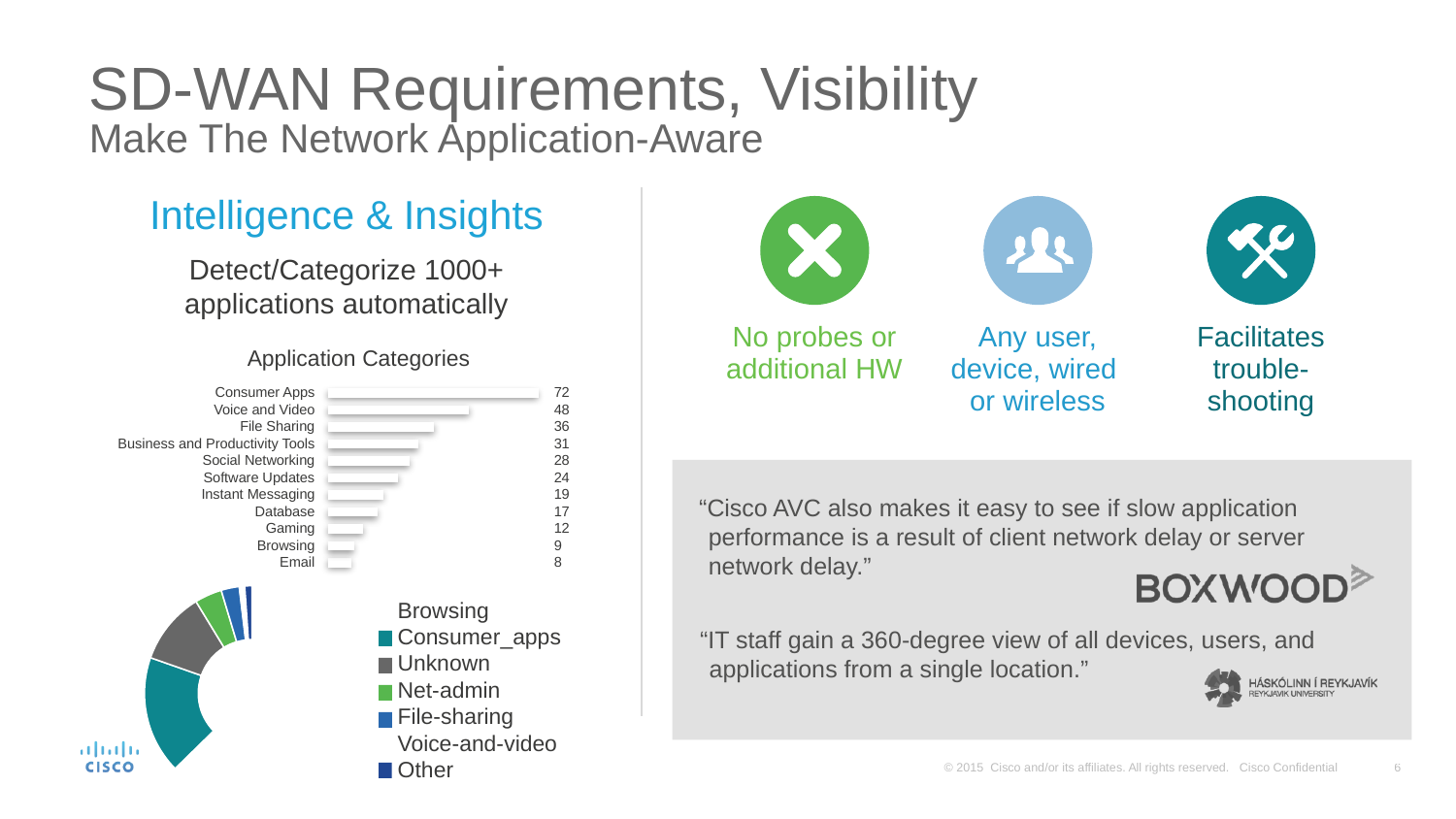
How many entries does the legend of the doughnut chart at the bottom left list? 7 In the Application Categories bar chart, which is larger, Software Updates or Instant Messaging? Software Updates What kind of chart is shown at the bottom left of the slide, below the bar chart? Doughnut chart In the Application Categories bar chart, what is the value for Social Networking? 28 In the Application Categories bar chart, what is the difference between Consumer Apps and Voice and Video? 24 How many categories are shown in the Application Categories bar chart? 11 In the Application Categories bar chart, what is the difference between File Sharing and Business and Productivity Tools? 5 In the Application Categories bar chart, what is the value for Gaming? 12 In the Application Categories bar chart, which category has the lowest value? Email In the Application Categories bar chart, what is the value for Consumer Apps? 72 In the Application Categories bar chart, which category has the highest value? Consumer Apps What kind of chart is the Application Categories chart? Bar chart